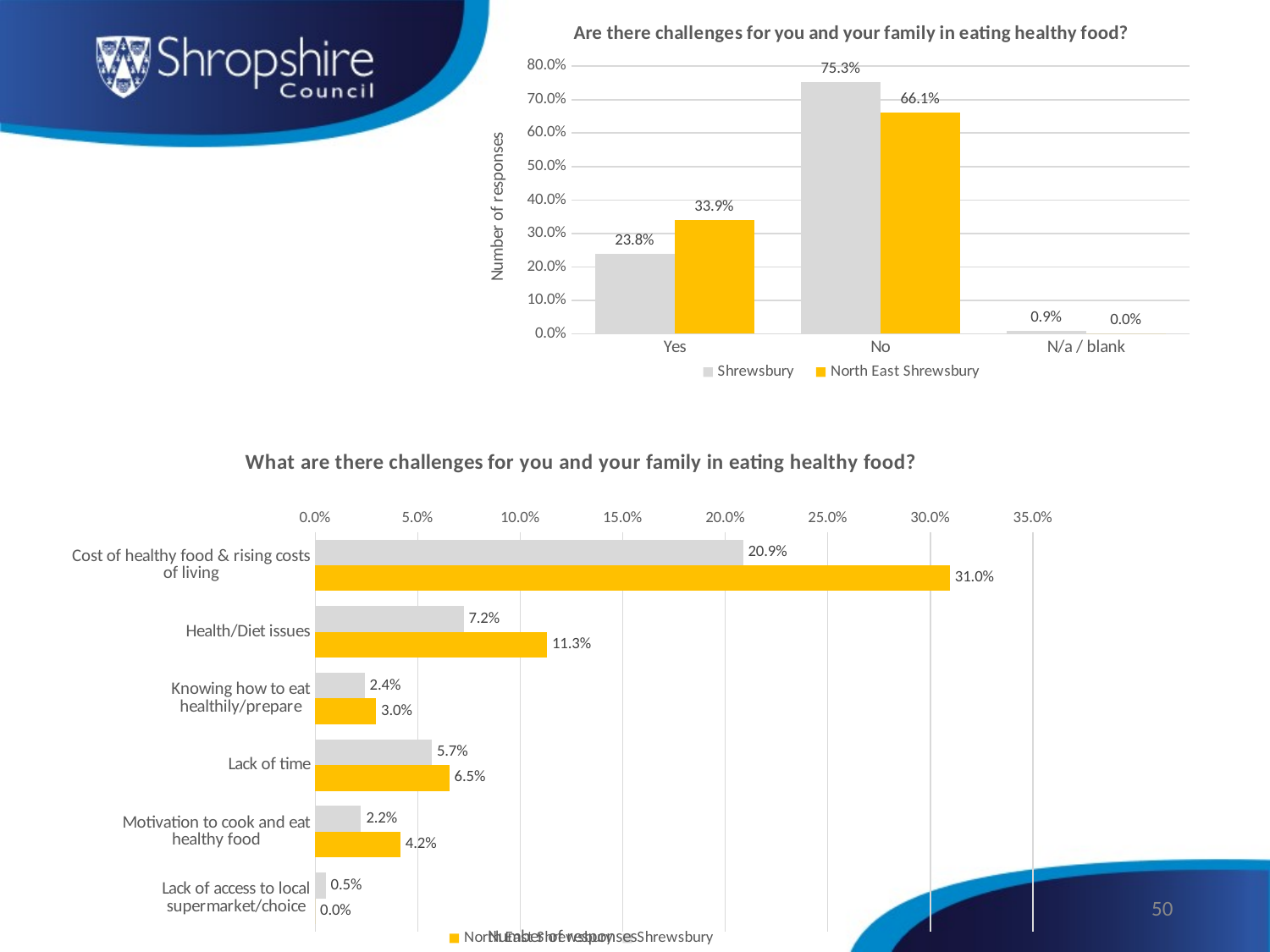
In the chart titled 'Are there challenges for you and your family in eating healthy food?', what is the difference between the Shrewsbury and North East Shrewsbury values for 'No'? 9.2% In the chart titled 'Are there challenges for you and your family in eating healthy food?', which category has the highest value for Shrewsbury? No In the chart titled 'Are there challenges for you and your family in eating healthy food?', what is the y-axis title? Number of responses In the chart titled 'What are there challenges for you and your family in eating healthy food?', what is the value of the yellow bar for 'Cost of healthy food & rising costs of living'? 31.0% What kind of chart is the chart titled 'What are there challenges for you and your family in eating healthy food?'? Bar chart In the chart titled 'What are there challenges for you and your family in eating healthy food?', how many categories are shown? 6 In the chart titled 'What are there challenges for you and your family in eating healthy food?', which category has the lowest value for the grey bars? Lack of access to local supermarket/choice In the chart titled 'Are there challenges for you and your family in eating healthy food?', how many series does the legend list? 2 In the chart titled 'Are there challenges for you and your family in eating healthy food?', what is the value for North East Shrewsbury for 'No'? 66.1% In the chart titled 'Are there challenges for you and your family in eating healthy food?', which is larger for 'Yes': Shrewsbury or North East Shrewsbury? North East Shrewsbury In the chart titled 'What are there challenges for you and your family in eating healthy food?', what is the value of the grey bar for 'Lack of time'? 5.7% In the chart titled 'Are there challenges for you and your family in eating healthy food?', what is the value for Shrewsbury for 'Yes'? 23.8%